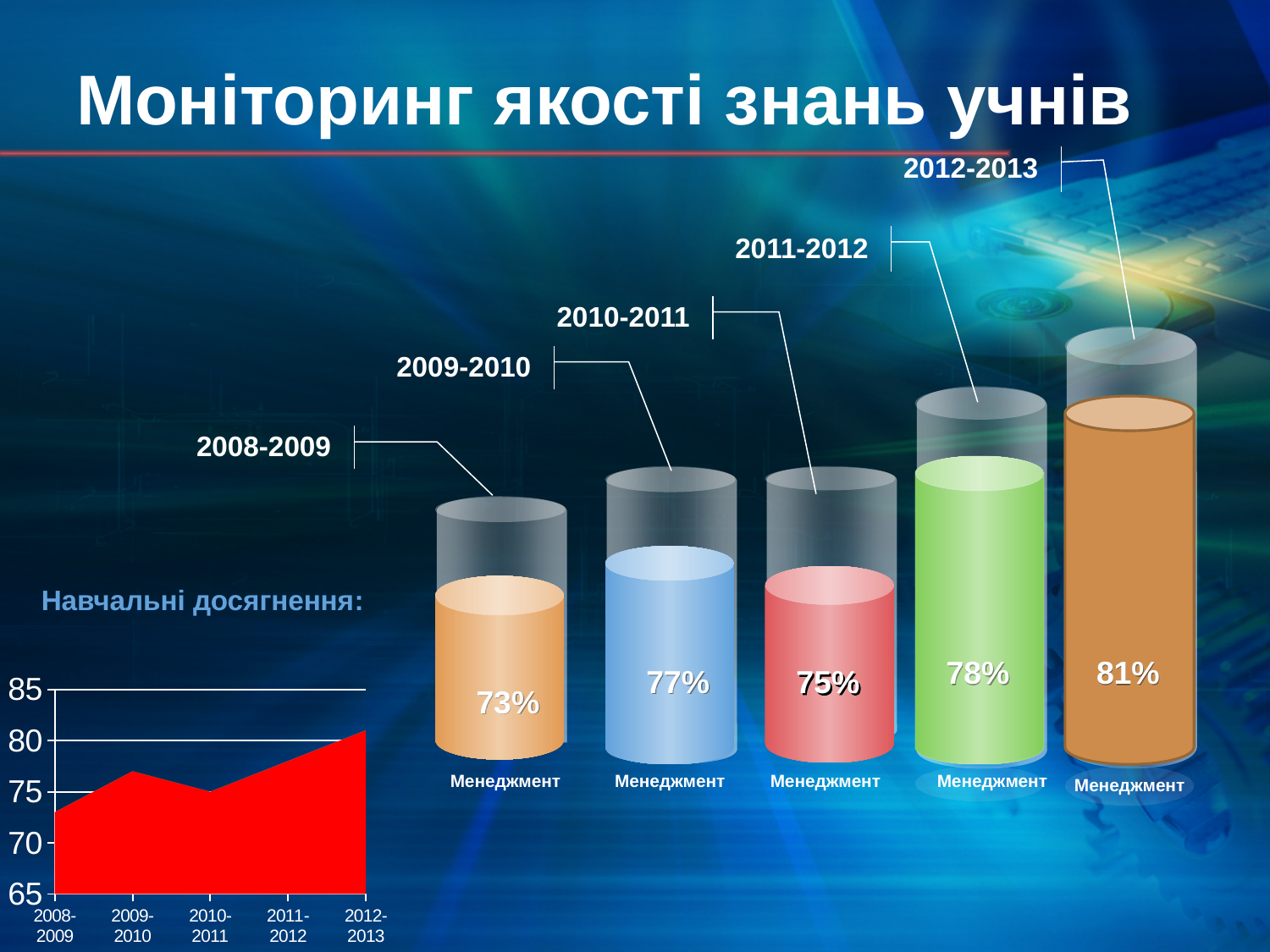
In the area chart at the bottom left, is the value for 2012-2013 greater or less than 80? greater In the area chart at the bottom left, is the value for 2008-2009 greater or less than 75? less In the cylinder chart on the right, what percentage is shown for 2009-2010? 77% In the cylinder chart on the right, which school year has the lowest percentage? 2008-2009 In the area chart at the bottom left, is the value for 2009-2010 greater or less than 75? greater In the cylinder chart on the right, what is the difference between the 2012-2013 value and the 2008-2009 value? 8% In the cylinder chart on the right, what label appears under each cylinder? Менеджмент In the area chart at the bottom left, do the values overall rise or fall from 2008-2009 to 2012-2013? rise In the cylinder chart on the right, which school year has the highest percentage? 2012-2013 In the cylinder chart on the right, what percentage is shown for 2010-2011? 75% What kind of chart is the small chart at the bottom left of the slide? area chart In the area chart at the bottom left, how many school years are shown on the x axis? 5